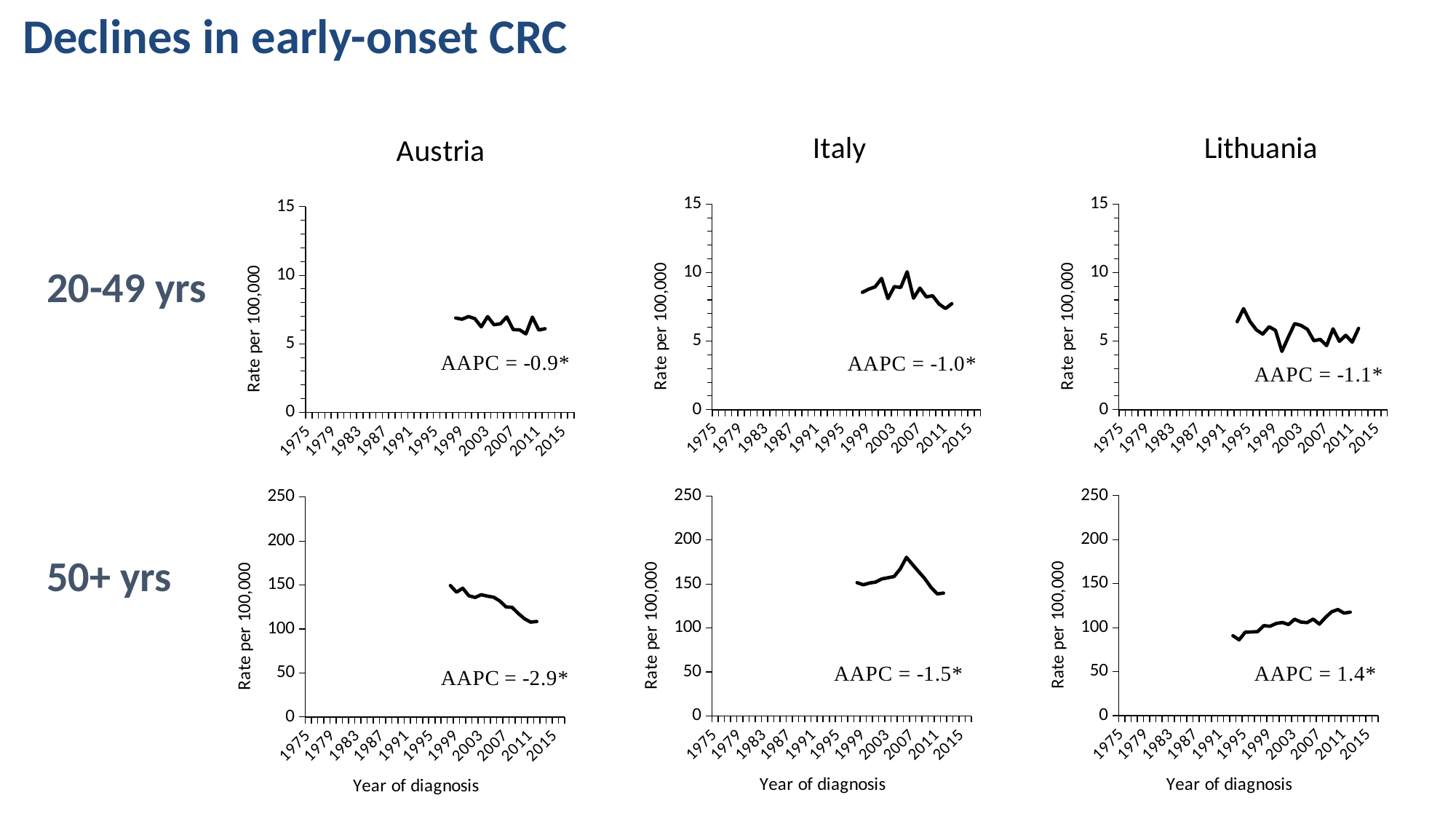
In the Italy 20-49 yrs chart, what is the AAPC value printed on the chart? -1.0* Around 2007, which chart shows a higher rate for 50+ yrs: Italy or Lithuania? Italy In the Austria 50+ yrs chart, does the rate rise or fall from 1999 to 2013? Fall Which of the six charts shows a positive AAPC? Lithuania 50+ yrs What kind of charts are shown on the slide? Line charts What is the y-axis label on the charts? Rate per 100,000 In the Italy 50+ yrs chart, is the peak value around 2007 greater or less than 150? greater In the Lithuania 50+ yrs chart, does the rate rise or fall from 1995 to 2013? Rise In the Lithuania 50+ yrs chart, what is the AAPC value printed on the chart? 1.4* How many charts are on the slide? 6 In the Austria 50+ yrs chart, what is the AAPC value printed on the chart? -2.9* In the Austria 20-49 yrs chart, what is the AAPC value printed on the chart? -0.9*